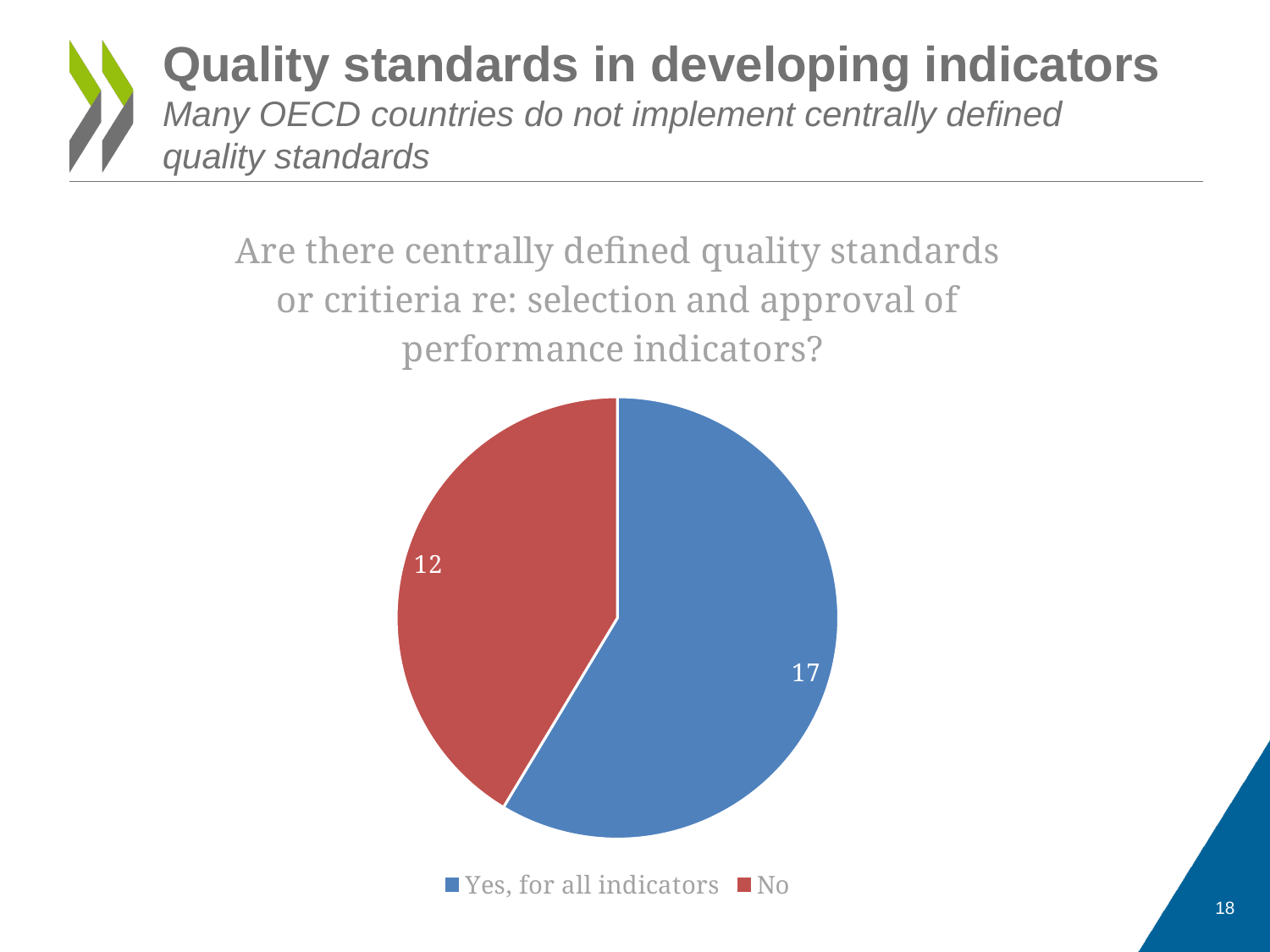
What is the title of the chart? Are there centrally defined quality standards or critieria re: selection and approval of performance indicators? What is the total of all slices in the pie chart? 29 What kind of chart is shown on the slide? pie chart Which category has the smallest slice? No Which category has the largest slice? Yes, for all indicators What is the difference between the values for "Yes, for all indicators" and "No"? 5 Which is larger, the value for "Yes, for all indicators" or the value for "No"? Yes, for all indicators What colour is the "No" slice? red What is the value for "No"? 12 How many slices does the pie chart have? 2 What is the value for "Yes, for all indicators"? 17 How many entries does the legend list? 2